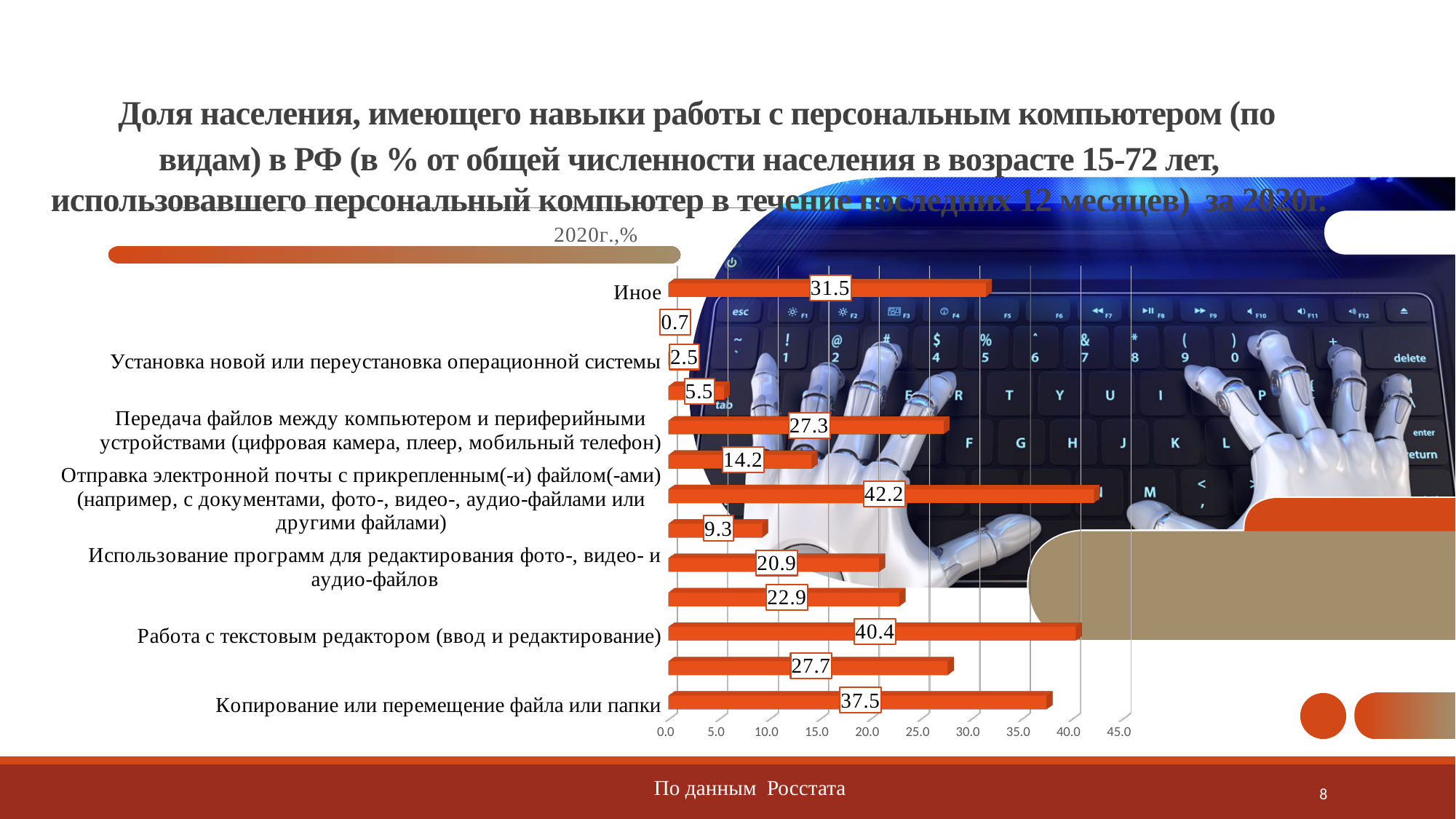
What is the value for "Копирование или перемещение файла или папки"? 37.5 Which is larger: the value for "Копирование или перемещение файла или папки" or the value for "Иное"? Копирование или перемещение файла или папки What type of chart is shown on the slide? bar chart How many bars are plotted in the chart? 13 What is the value for "Отправка электронной почты с прикрепленным(-и) файлом(-ами)"? 42.2 What is the title shown above the chart? 2020г.,% What is the difference between the values for "Отправка электронной почты с прикрепленным(-и) файлом(-ами)" and "Работа с текстовым редактором"? 1.8 What is the value for "Иное"? 31.5 What is the value for "Передача файлов между компьютером и периферийными устройствами"? 27.3 What is the value for "Работа с текстовым редактором (ввод и редактирование)"? 40.4 What is the value for "Установка новой или переустановка операционной системы"? 2.5 Which labelled category has the highest value? Отправка электронной почты с прикрепленным(-и) файлом(-ами)